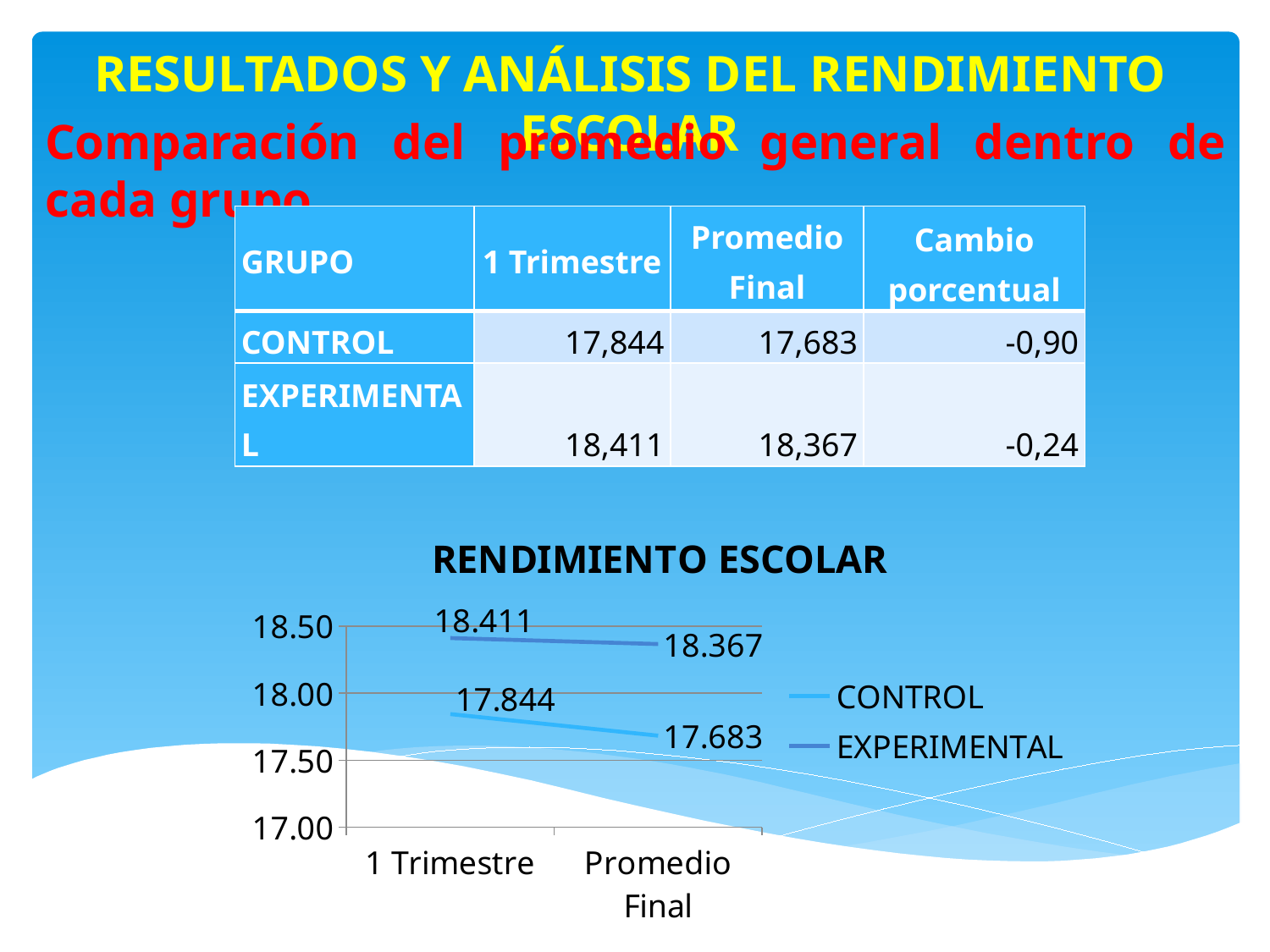
What is the value for EXPERIMENTAL at 1 Trimestre? 18.411 What is the value for CONTROL at Promedio Final? 17.683 What is the difference between the EXPERIMENTAL and CONTROL values at 1 Trimestre? 0.567 Does the CONTROL series rise or fall from 1 Trimestre to Promedio Final? fall How many series does the chart legend list? 2 How many categories are shown on the x axis of the chart? 2 What is the value for EXPERIMENTAL at Promedio Final? 18.367 What type of chart is shown under the title RENDIMIENTO ESCOLAR? line chart What is the title of the chart? RENDIMIENTO ESCOLAR Which series has the higher value at Promedio Final, CONTROL or EXPERIMENTAL? EXPERIMENTAL What is the value for CONTROL at 1 Trimestre? 17.844 What is the difference between the CONTROL values at 1 Trimestre and Promedio Final? 0.161